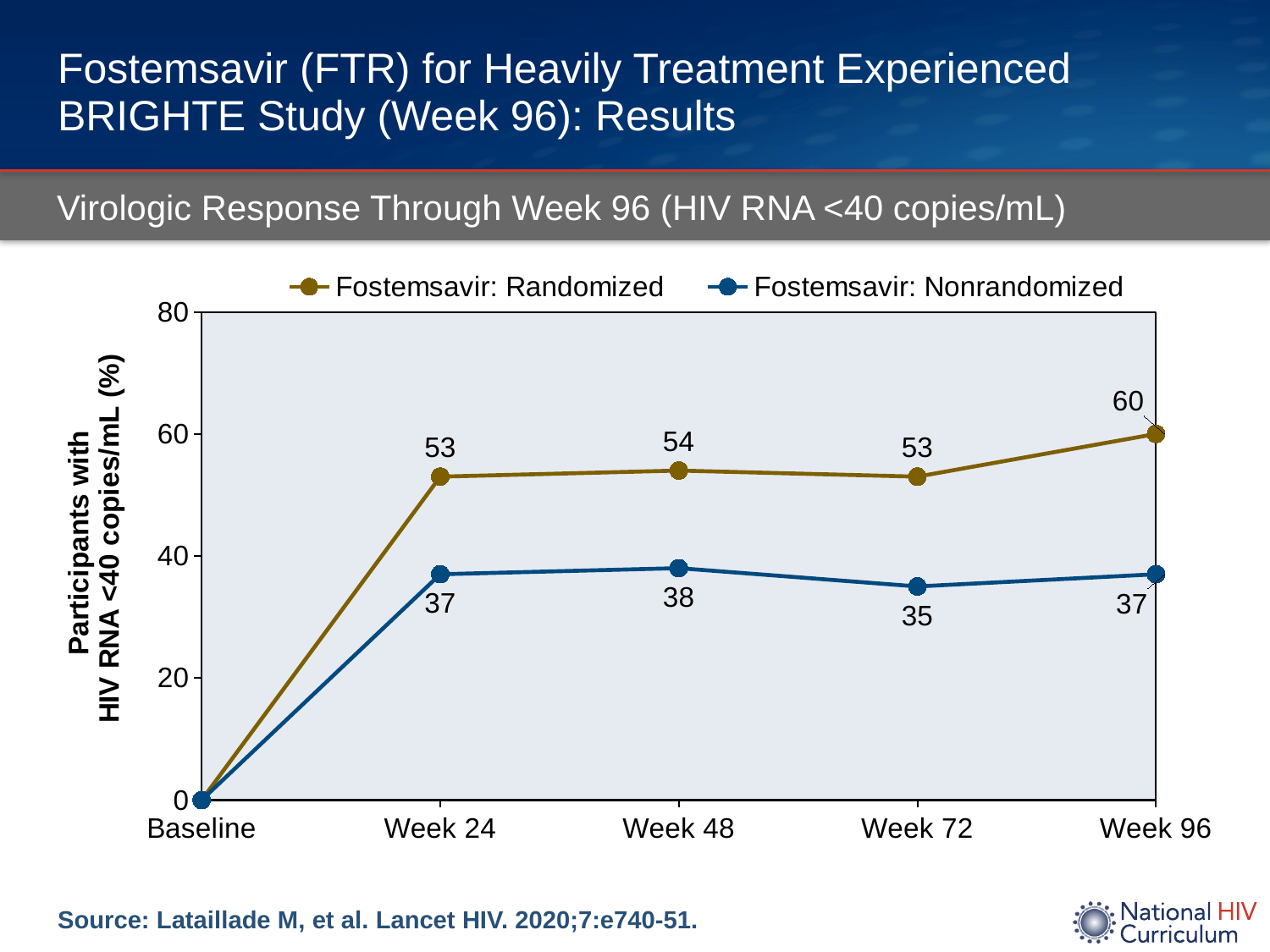
What is the value for Fostemsavir: Nonrandomized at Week 48? 38 What is the difference between the Fostemsavir: Randomized and Fostemsavir: Nonrandomized values at Week 96? 23 What is the value for Fostemsavir: Randomized at Week 24? 53 At which time point is the Fostemsavir: Randomized series highest? Week 96 Does the Fostemsavir: Randomized series rise or fall from Week 72 to Week 96? Rise How many series does the legend list? 2 At which time point is the Fostemsavir: Nonrandomized series lowest (excluding Baseline)? Week 72 What is the value for Fostemsavir: Nonrandomized at Week 72? 35 Which series has the larger value at Week 48, Fostemsavir: Randomized or Fostemsavir: Nonrandomized? Fostemsavir: Randomized What is the value for Fostemsavir: Randomized at Week 96? 60 What kind of chart is shown on the slide? Line chart How many time points are plotted on the x axis? 5